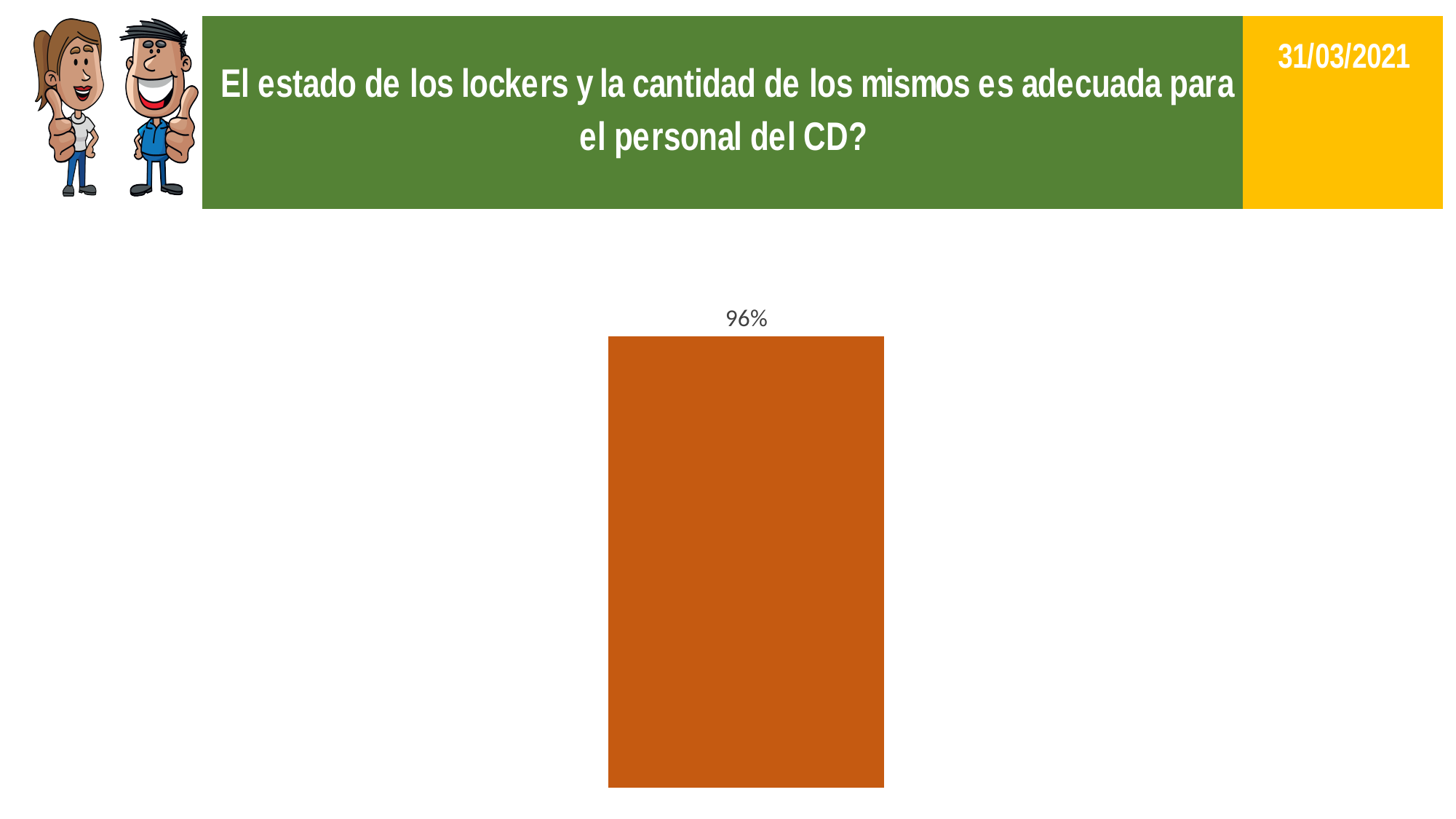
What is the highest value shown in the chart? 96% What value is printed on the single bar in the chart? 96% Is the value shown on the bar greater or less than 90%? greater How many bars does the chart show? 1 What kind of chart is shown on the slide? bar chart What colour is the bar in the chart? orange